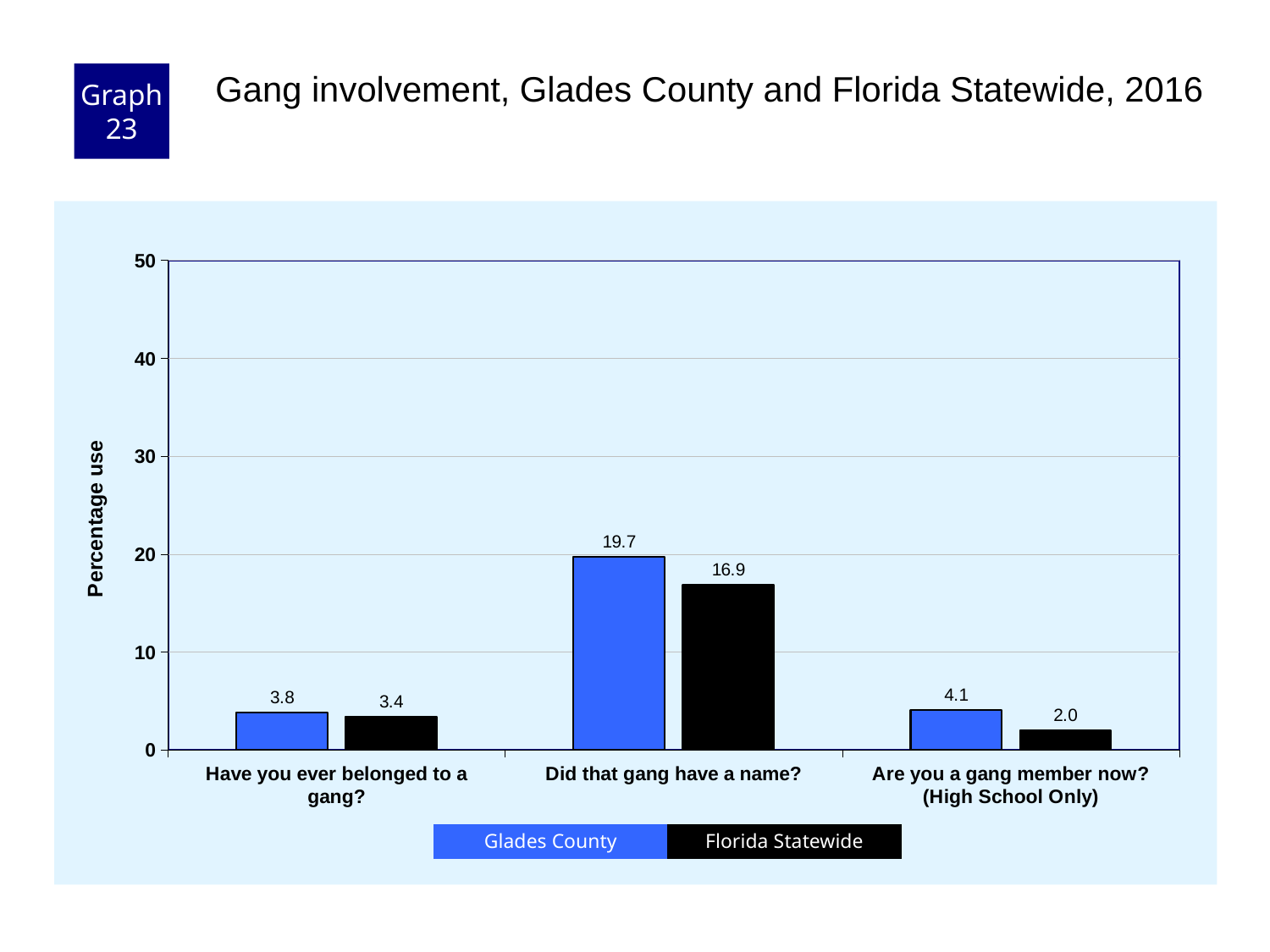
What is the Florida Statewide value for "Have you ever belonged to a gang?"? 3.4 What is the Glades County value for "Did that gang have a name?"? 19.7 What is the difference between the Glades County and Florida Statewide values for "Did that gang have a name?"? 2.8 How many questions (categories) are shown on the x axis? 3 What is the Florida Statewide value for "Are you a gang member now? (High School Only)"? 2.0 For "Are you a gang member now? (High School Only)", which is larger: Glades County or Florida Statewide? Glades County What is the label of the y axis? Percentage use Is the Florida Statewide value for "Did that gang have a name?" greater or less than 20? less What kind of chart is shown? Bar chart Which question has the highest Glades County value? Did that gang have a name? How many series does the legend list? 2 Which question has the lowest Florida Statewide value? Are you a gang member now? (High School Only)